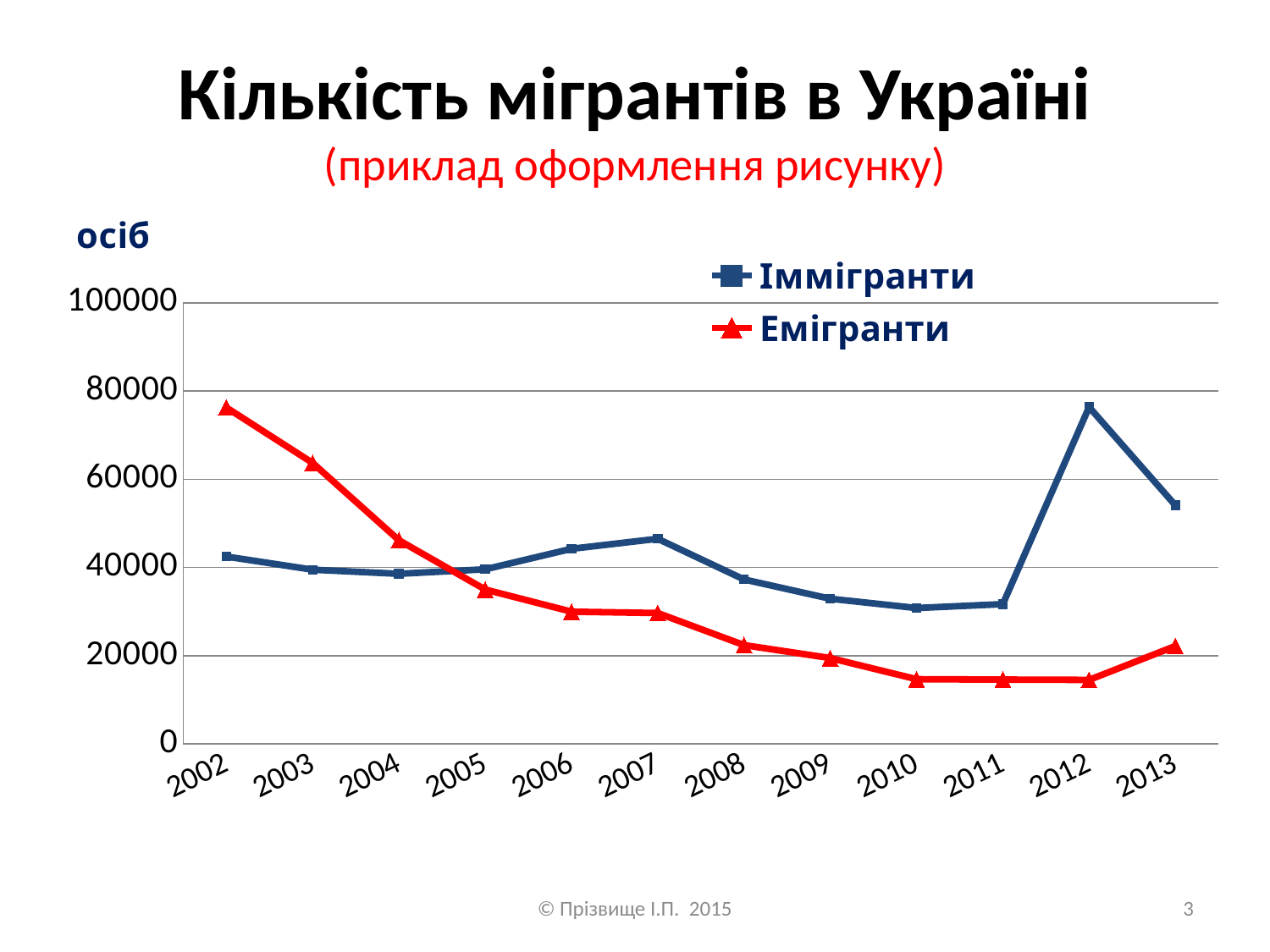
What are the two series named in the legend? Іммігранти and Емігранти Does the Емігранти series rise or fall from 2002 to 2007? fall How many series does the legend list? 2 In which year does the Іммігранти series reach its highest value? 2012 Is the value for Емігранти in 2010 greater or less than 20000? less Is the value for Емігранти in 2002 greater or less than 60000? greater In which year does the Емігранти series reach its highest value? 2002 What kind of chart is shown on the slide? line chart How many years are shown along the x axis? 12 In 2002, which series has the larger value, Іммігранти or Емігранти? Емігранти In 2012, which series has the larger value, Іммігранти or Емігранти? Іммігранти What unit label is shown above the vertical axis? осіб